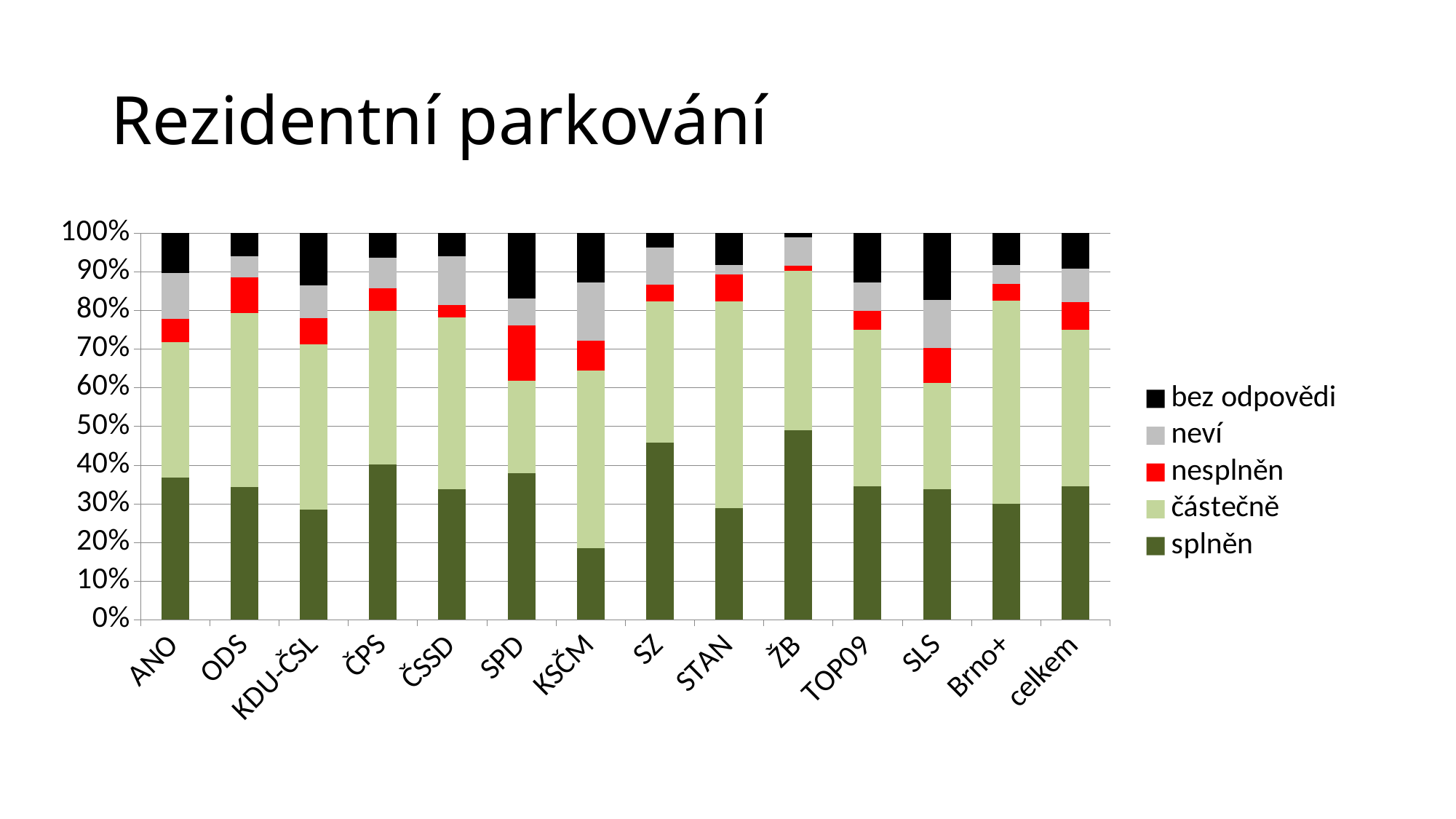
What is the title of the slide? Rezidentní parkování How many categories are shown on the x axis? 14 Which category has the largest 'nesplněn' segment? SPD Which category has the lowest value for the 'splněn' series? KSČM What kind of chart is shown on the slide? stacked bar chart Which legend entry is shown in black? bez odpovědi How many series does the legend list? 5 Is the 'splněn' value for KSČM greater or less than 30%? less Is the 'splněn' value for ŽB greater or less than 40%? greater Which has a larger 'splněn' value, SZ or ODS? SZ Is the 'splněn' value for ČPS greater or less than 30%? greater Which category has the smallest 'bez odpovědi' segment? ŽB